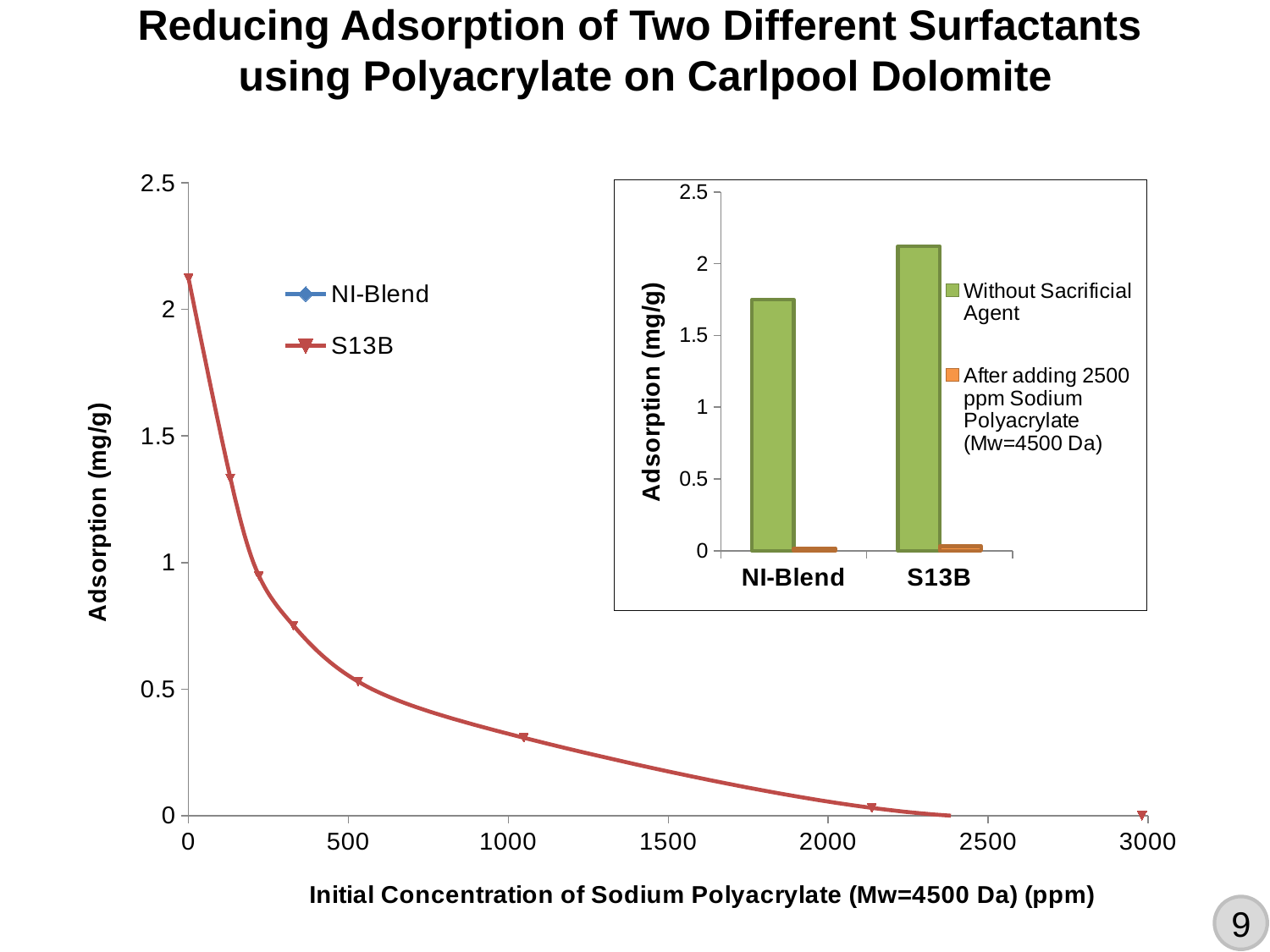
What kind of chart is the large main chart on the slide? line chart What is the label of the y axis of the main chart? Adsorption (mg/g) What kind of chart is the inset chart in the upper right of the slide? bar chart In the inset bar chart, is the adsorption of S13B without sacrificial agent greater or less than 2? greater In the inset bar chart, which surfactant has the higher adsorption without sacrificial agent, NI-Blend or S13B? S13B In the inset bar chart, is the adsorption of NI-Blend without sacrificial agent greater or less than 1.5? greater How many categories are shown on the x axis of the inset bar chart? 2 How many series does the legend of the main chart list? 2 In the inset bar chart, is the adsorption of NI-Blend after adding 2500 ppm sodium polyacrylate greater or less than 0.5? less In the main chart, does the S13B adsorption rise or fall as the initial concentration of sodium polyacrylate increases? fall How many series does the legend of the inset bar chart list? 2